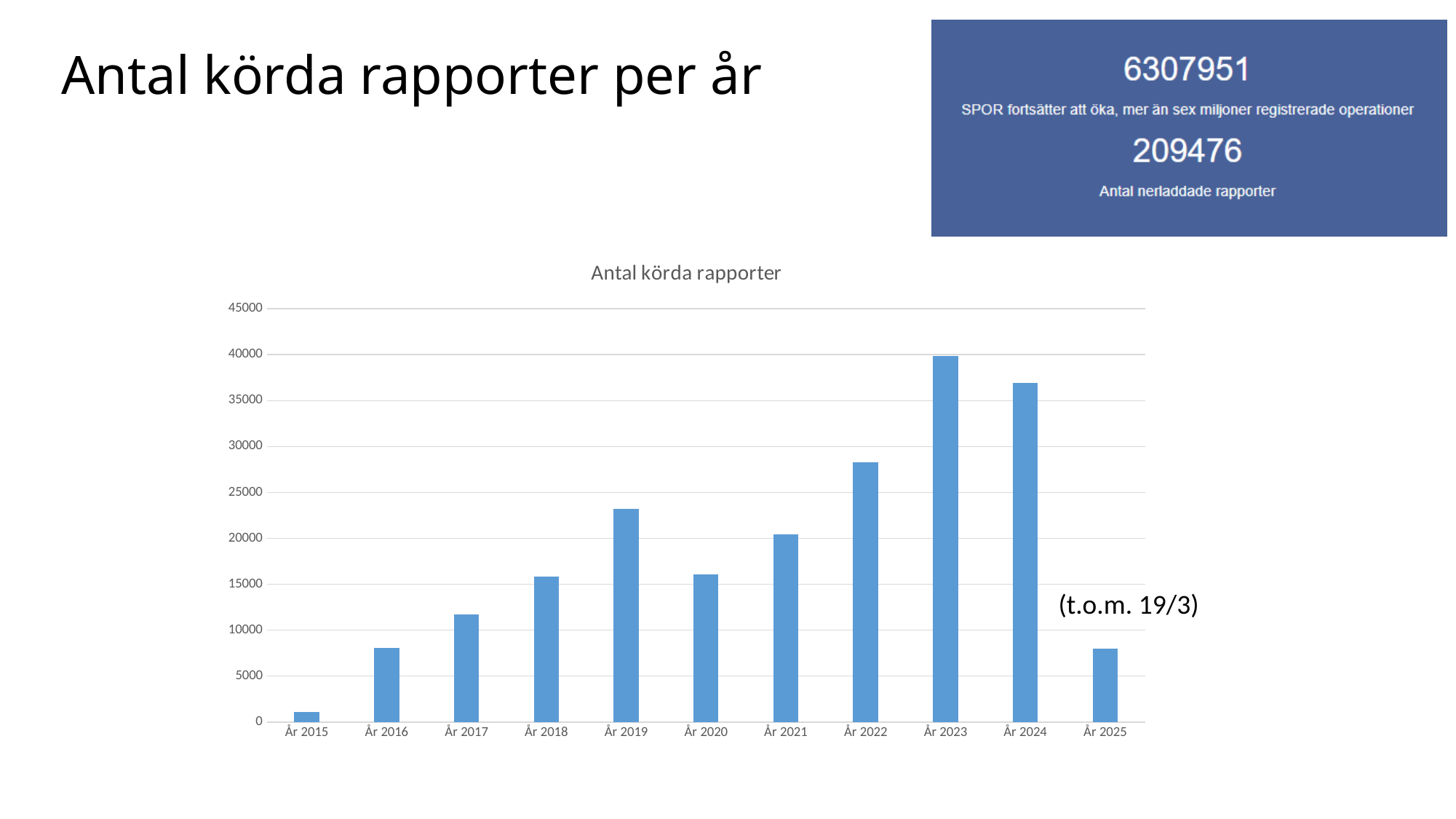
Is the value for År 2024 greater or less than 40000? less Which year has the larger value, År 2019 or År 2020? År 2019 Is the value for År 2017 greater or less than 10000? greater Which year has the lowest number of reports in the chart? År 2015 Is the value for År 2020 greater or less than 20000? less How many years are shown on the x axis of the chart? 11 What kind of chart is shown on the slide? bar chart Which year has the highest number of reports in the chart? År 2023 Do the values generally rise or fall from År 2015 to År 2023? rise Which year has the larger value, År 2023 or År 2024? År 2023 What is the title of the chart? Antal körda rapporter